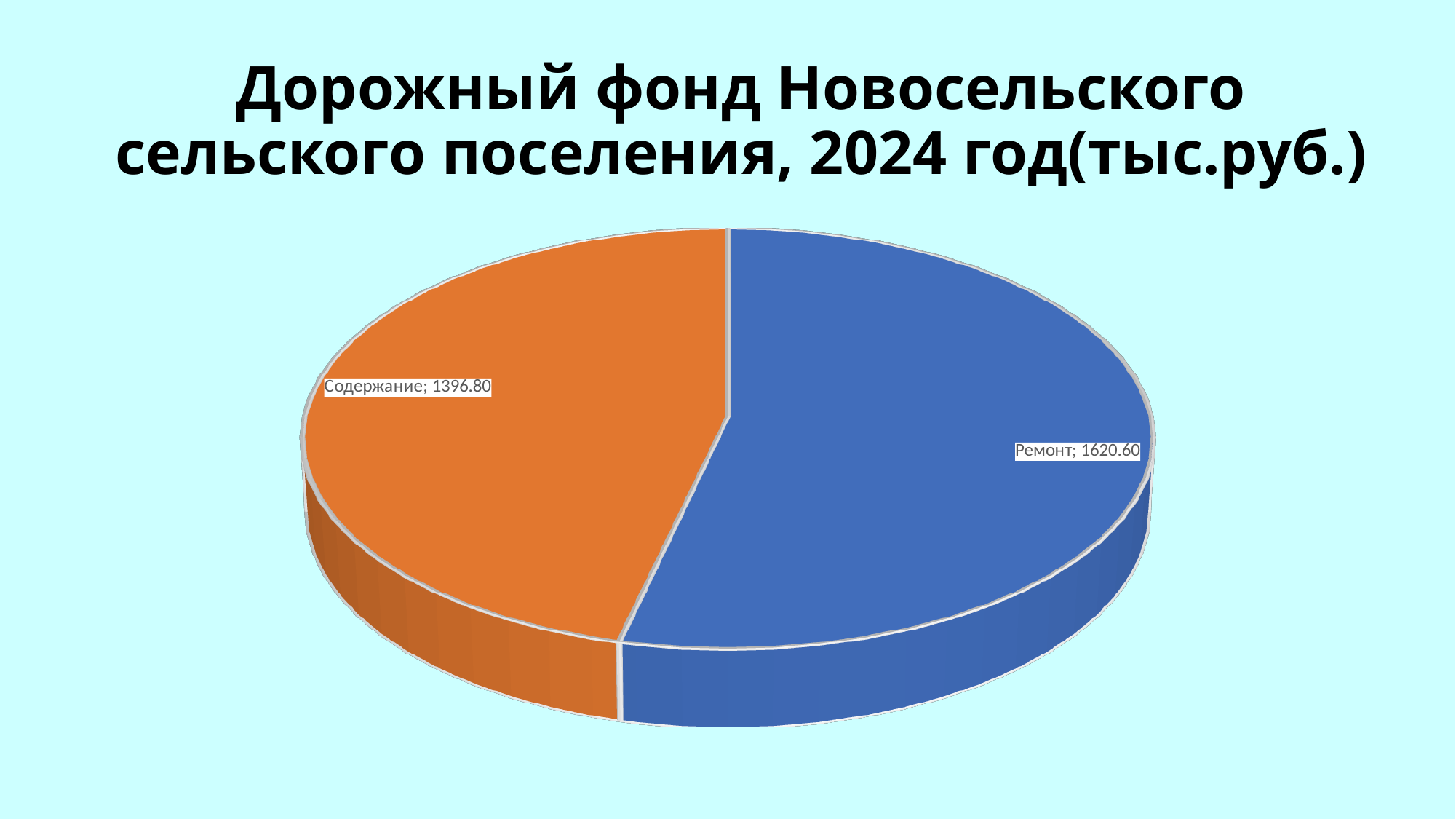
What colour is the slice for Содержание? orange Which category has the smallest slice of the pie? Содержание What share of the pie does Ремонт represent, to the nearest whole percent? 54% What is the total of all slices in the pie chart? 3017.40 What is the title of the chart? Дорожный фонд Новосельского сельского поселения, 2024 год(тыс.руб.) What is the value for Содержание? 1396.80 Which category has the largest slice of the pie? Ремонт What is the difference between the values for Ремонт and Содержание? 223.80 What is the value for Ремонт? 1620.60 Which is larger, the value for Ремонт or the value for Содержание? Ремонт How many slices does the pie chart have? 2 What type of chart is shown on the slide? pie chart